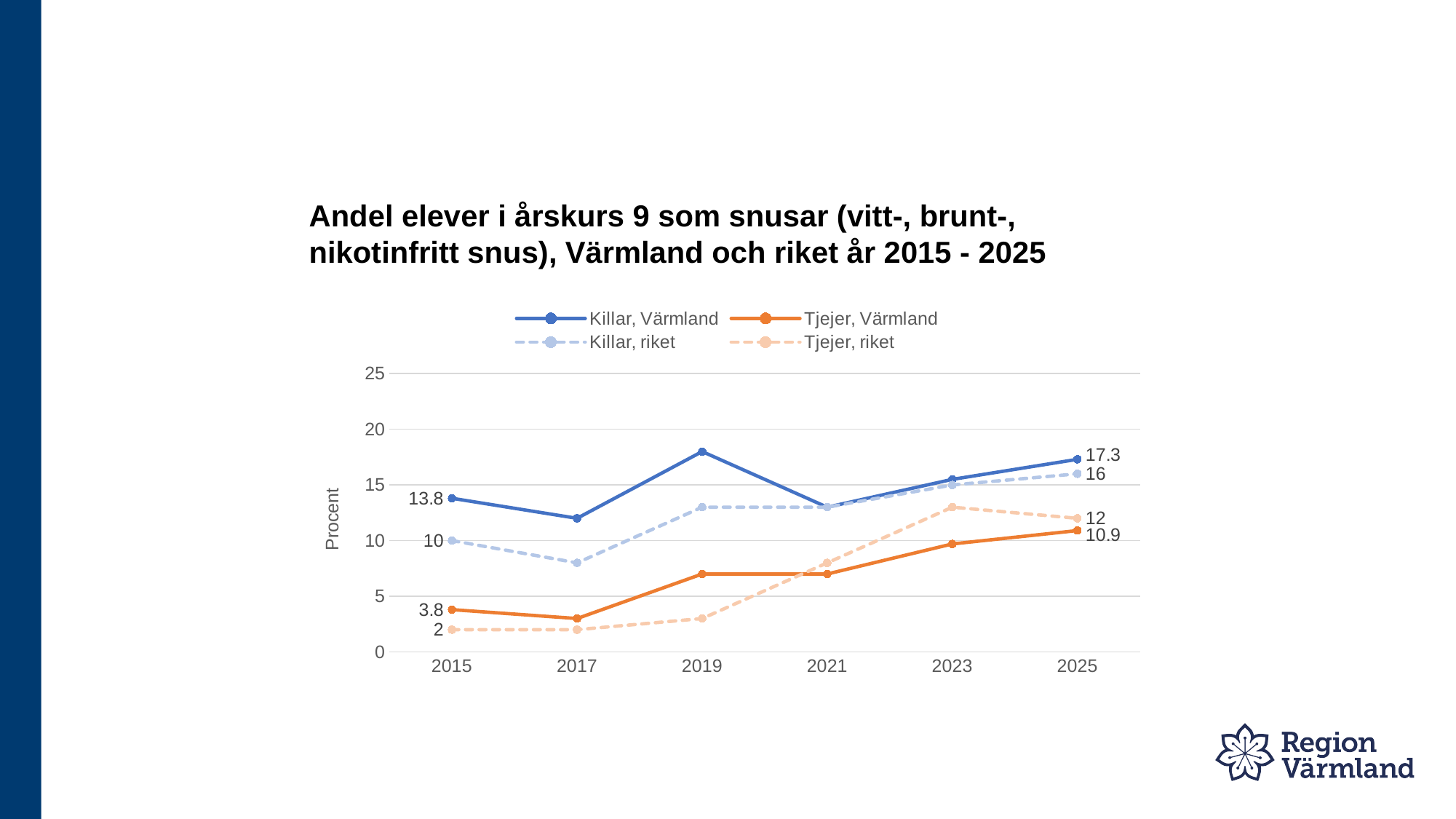
What is the value for Killar, riket in 2025? 16 What type of chart is shown on the slide? line chart What is the value for Tjejer, Värmland in 2025? 10.9 How many series does the legend list? 4 What is the difference between Killar, Värmland and Tjejer, Värmland in 2015? 10 Which series has the highest value in 2025? Killar, Värmland What is the value for Killar, Värmland in 2015? 13.8 What is the value for Tjejer, riket in 2015? 2 What is the difference between Killar, Värmland in 2025 and in 2015? 3.5 Is the value for Killar, Värmland in 2019 greater or less than 15? greater Does the Tjejer, riket series rise or fall from 2015 to 2025? rise How many years are shown on the x axis? 6